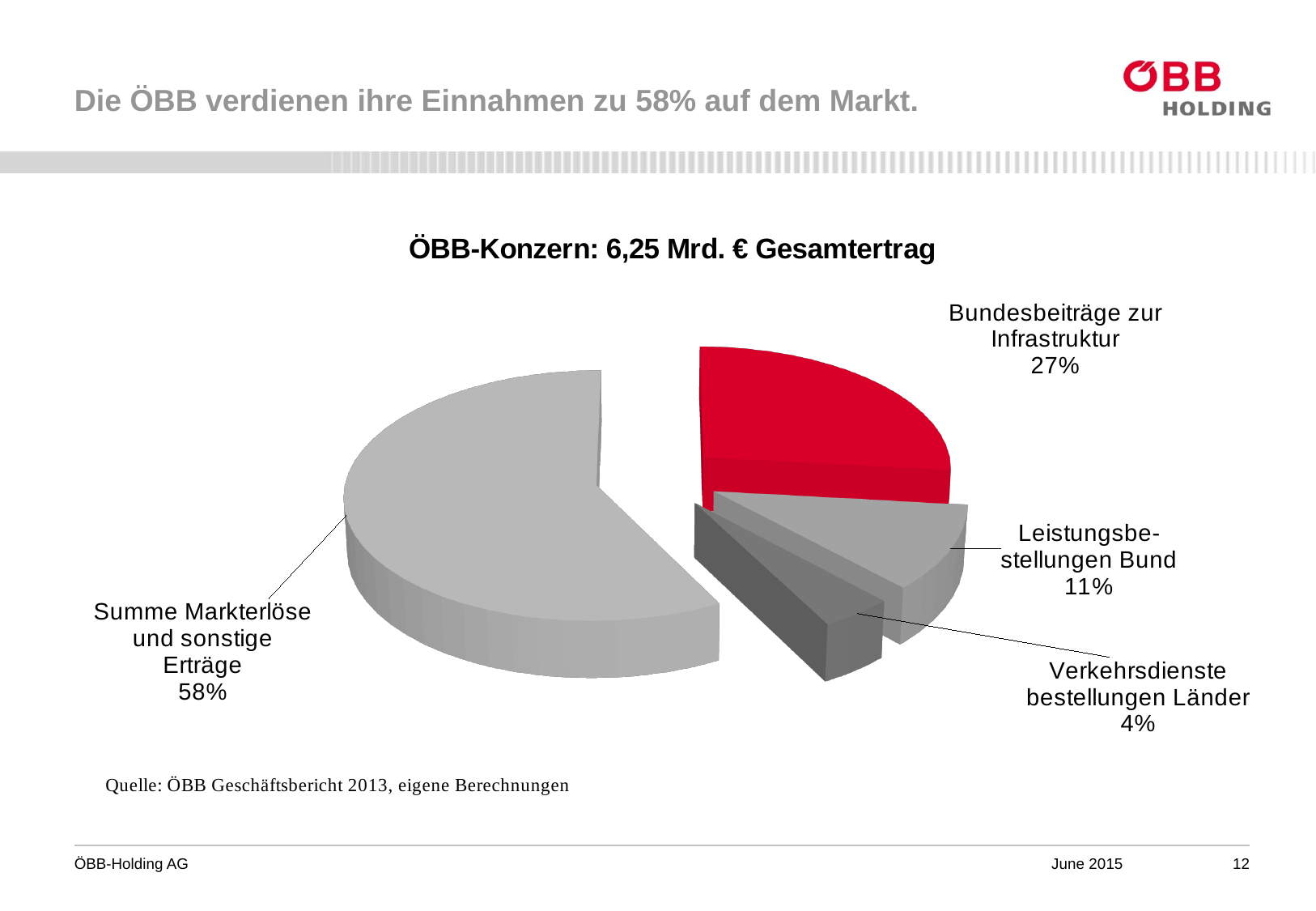
Which slice of the pie is the largest? Summe Markterlöse und sonstige Erträge What is the difference in percentage points between 'Bundesbeiträge zur Infrastruktur' and 'Leistungsbestellungen Bund'? 16 percentage points What share of the pie is 'Summe Markterlöse und sonstige Erträge'? 58% What share of the pie is 'Verkehrsdienstebestellungen Länder'? 4% How many slices does the pie chart have? 4 What share of the pie is 'Bundesbeiträge zur Infrastruktur'? 27% What is the title of the chart? ÖBB-Konzern: 6,25 Mrd. € Gesamtertrag Which slice of the pie is coloured red? Bundesbeiträge zur Infrastruktur Which is larger: 'Leistungsbestellungen Bund' or 'Verkehrsdienstebestellungen Länder'? Leistungsbestellungen Bund Which slice of the pie is the smallest? Verkehrsdienstebestellungen Länder What type of chart is shown on the slide? Pie chart